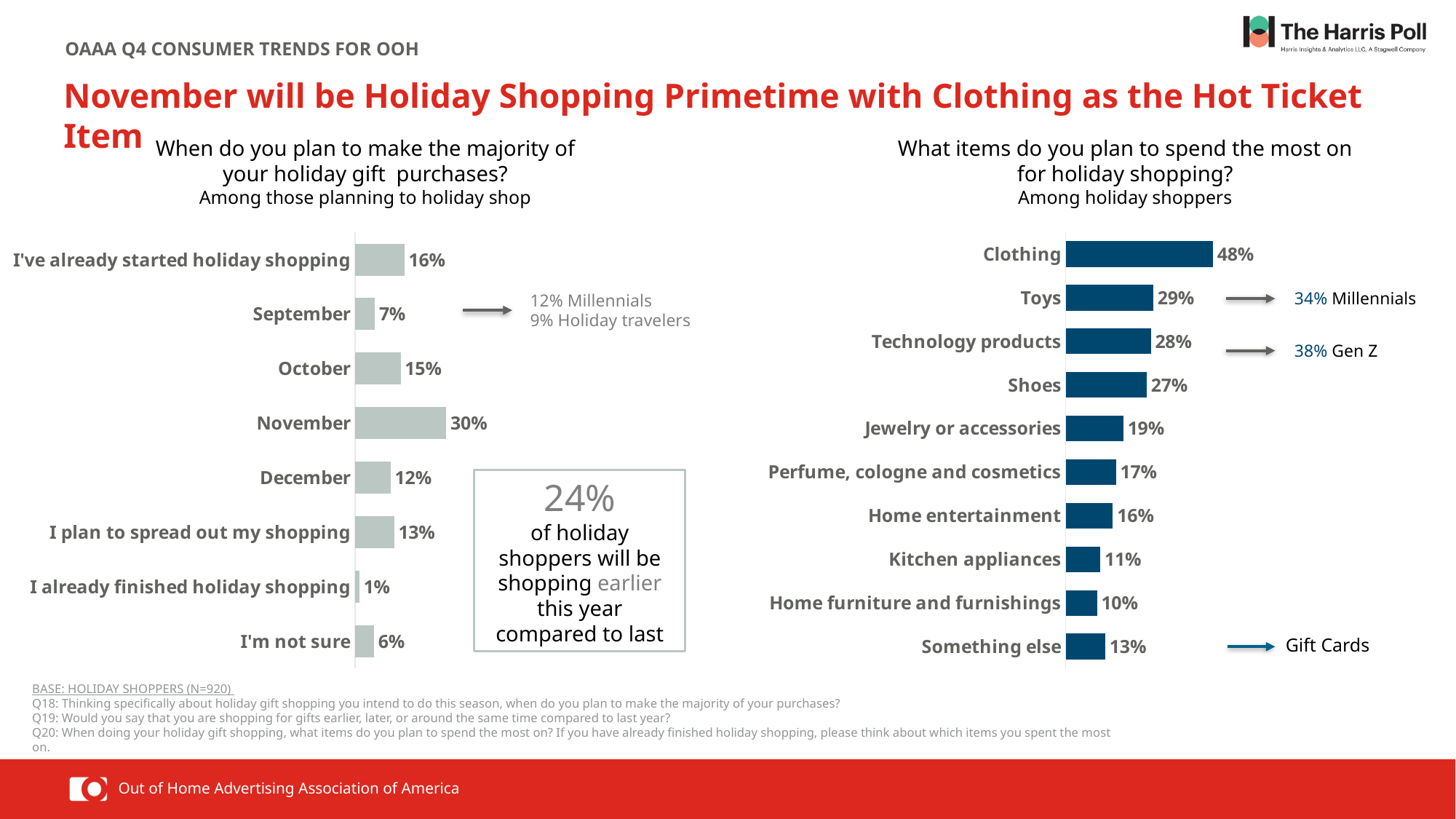
In the right chart (What items do you plan to spend the most on for holiday shopping?), which item has the lowest value? Home furniture and furnishings In the right chart (What items do you plan to spend the most on for holiday shopping?), what percentage plan to spend the most on Clothing? 48% In the right chart (What items do you plan to spend the most on for holiday shopping?), what is the difference between Clothing and Toys? 19% In the right chart (What items do you plan to spend the most on for holiday shopping?), what percentage of Gen Z plan to spend the most on Technology products, according to the annotation? 38% In the right chart (What items do you plan to spend the most on for holiday shopping?), how many items are listed? 10 In the left chart (When do you plan to make the majority of your holiday gift purchases?), what is the difference between the November and December values? 18% In the left chart (When do you plan to make the majority of your holiday gift purchases?), how many categories are shown? 8 In the left chart (When do you plan to make the majority of your holiday gift purchases?), what percentage plan to make the majority of their purchases in November? 30% In the left chart (When do you plan to make the majority of your holiday gift purchases?), which category has the lowest value? I already finished holiday shopping In the right chart (What items do you plan to spend the most on for holiday shopping?), which item has the highest value? Clothing What kind of chart is the right chart (What items do you plan to spend the most on for holiday shopping?)? Bar chart In the left chart (When do you plan to make the majority of your holiday gift purchases?), which is larger: October or September? October